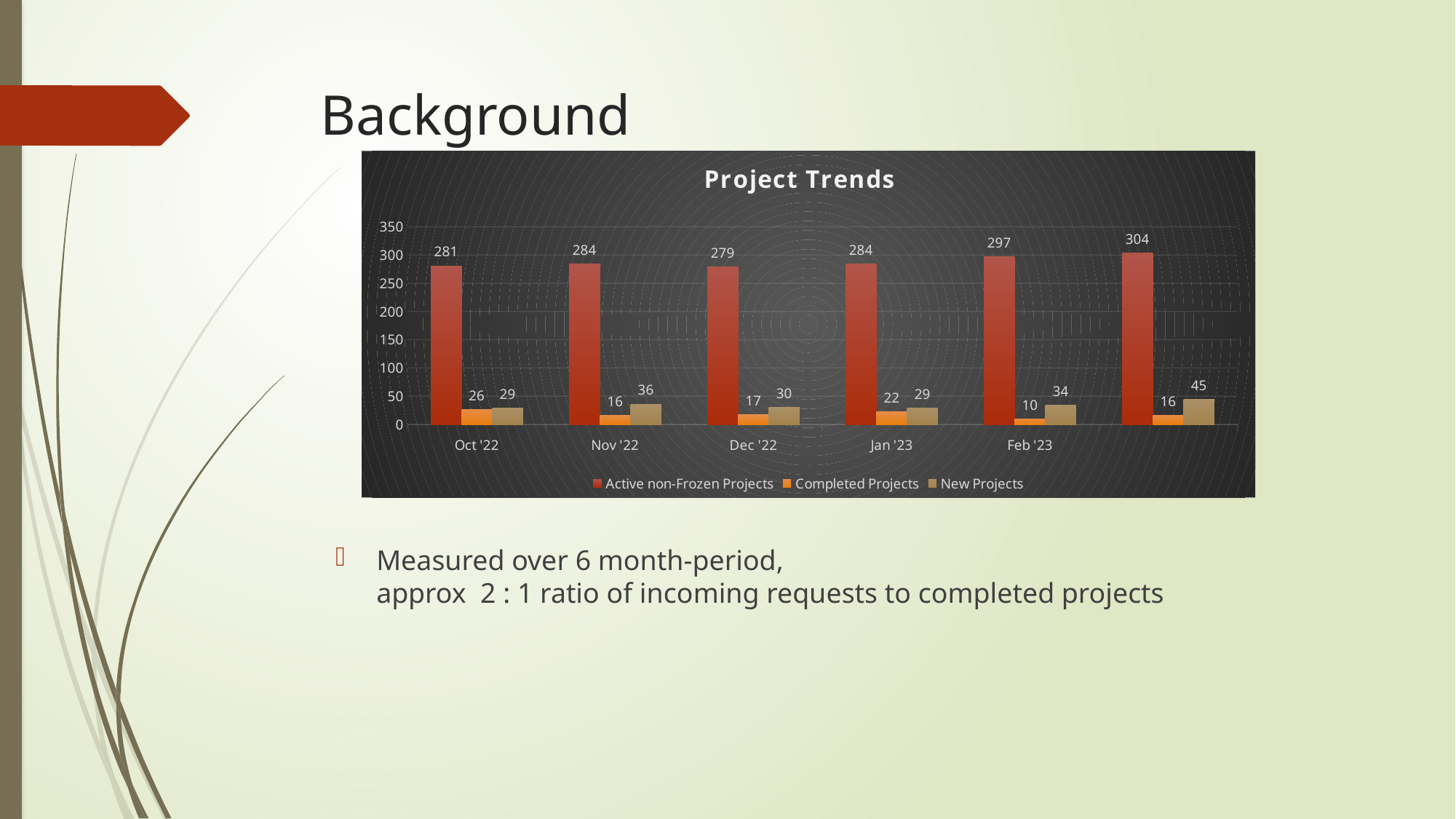
Is the value for Active non-Frozen Projects in Feb '23 greater or less than 250? greater What is the value for Completed Projects in Nov '22? 16 Which is larger: Completed Projects in Oct '22 or in Jan '23? Oct '22 How many groups of bars are plotted in the chart? 6 What kind of chart is shown on the slide? bar chart What is the value for New Projects in Feb '23? 34 Which month has the lowest value for Completed Projects? Feb '23 What is the value for Active non-Frozen Projects in Oct '22? 281 How many series does the legend list? 3 What is the difference in Active non-Frozen Projects between Feb '23 and Jan '23? 13 Which month has the lowest value for Active non-Frozen Projects? Dec '22 What is the difference between New Projects and Completed Projects in Nov '22? 20